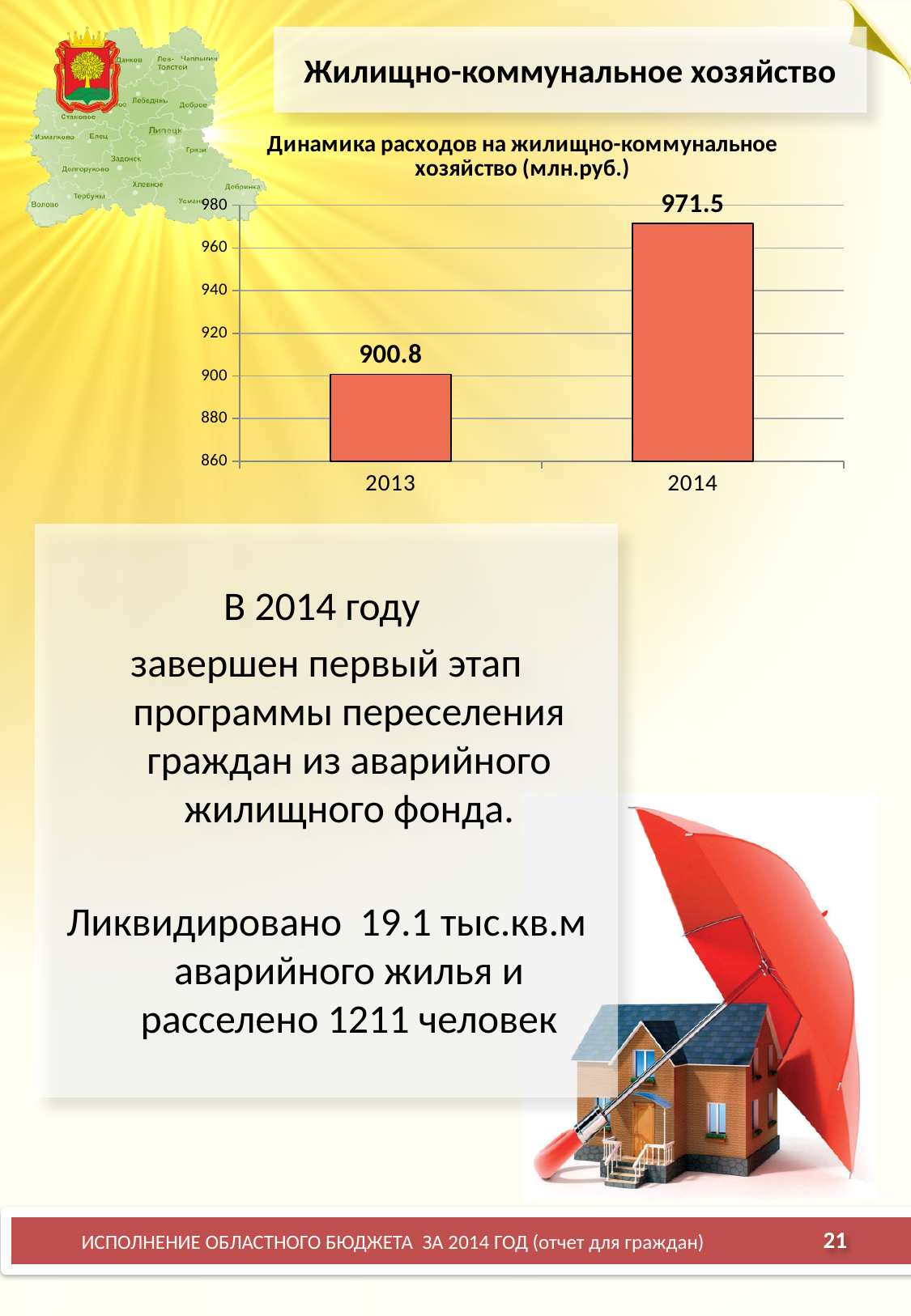
Do the values rise or fall from 2013 to 2014? rise Which year has the highest expenditure in the chart? 2014 How many categories are shown on the x axis of the chart? 2 Is the value for 2014 greater or less than 960? greater Is the value for 2013 greater or less than 920? less Which is larger, the value for 2013 or the value for 2014? 2014 What unit is given in the chart title? млн.руб. What is the value for 2014 in the chart? 971.5 What is the difference between the 2014 and 2013 values in the chart? 70.7 Which year has the lowest expenditure in the chart? 2013 What kind of chart is shown on the slide? bar chart What is the value for 2013 in the chart? 900.8